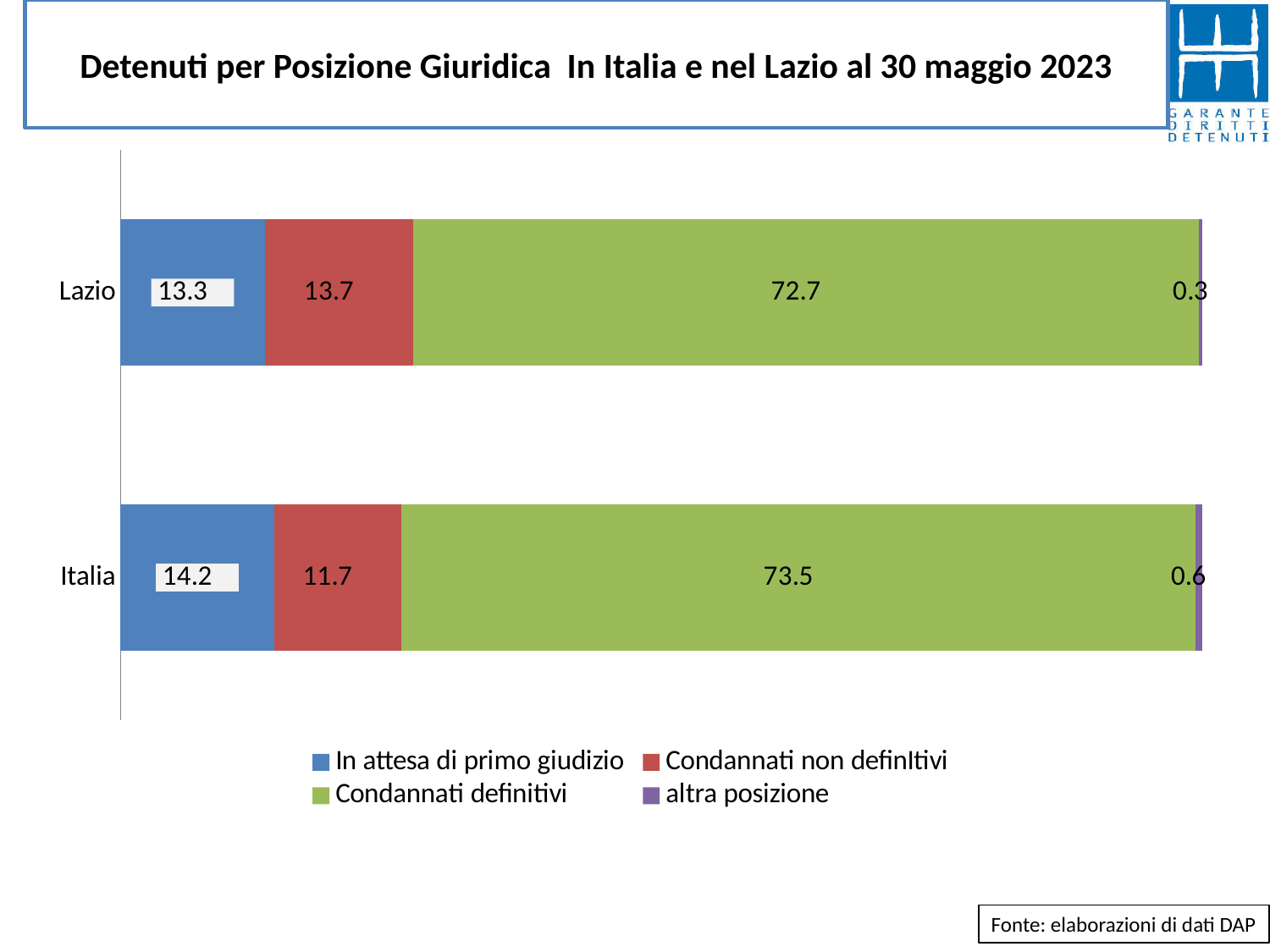
Which category has the higher value for 'Condannati non definitivi', Lazio or Italia? Lazio What kind of chart is shown on the slide? Stacked bar chart What is the value for 'Condannati non definitivi' for Lazio? 13.7 What is the value for 'Condannati definitivi' for Italia? 73.5 Which series has the smallest value in the Italia bar? altra posizione What is the value for 'altra posizione' for Italia? 0.6 What is the difference between the 'Condannati definitivi' values for Italia and Lazio? 0.8 What is the value for 'In attesa di primo giudizio' for Lazio? 13.3 How many series does the legend list? 4 Which category has the higher value for 'In attesa di primo giudizio', Lazio or Italia? Italia What is the difference between the 'Condannati non definitivi' values for Lazio and Italia? 2.0 Which series has the largest value in the Lazio bar? Condannati definitivi